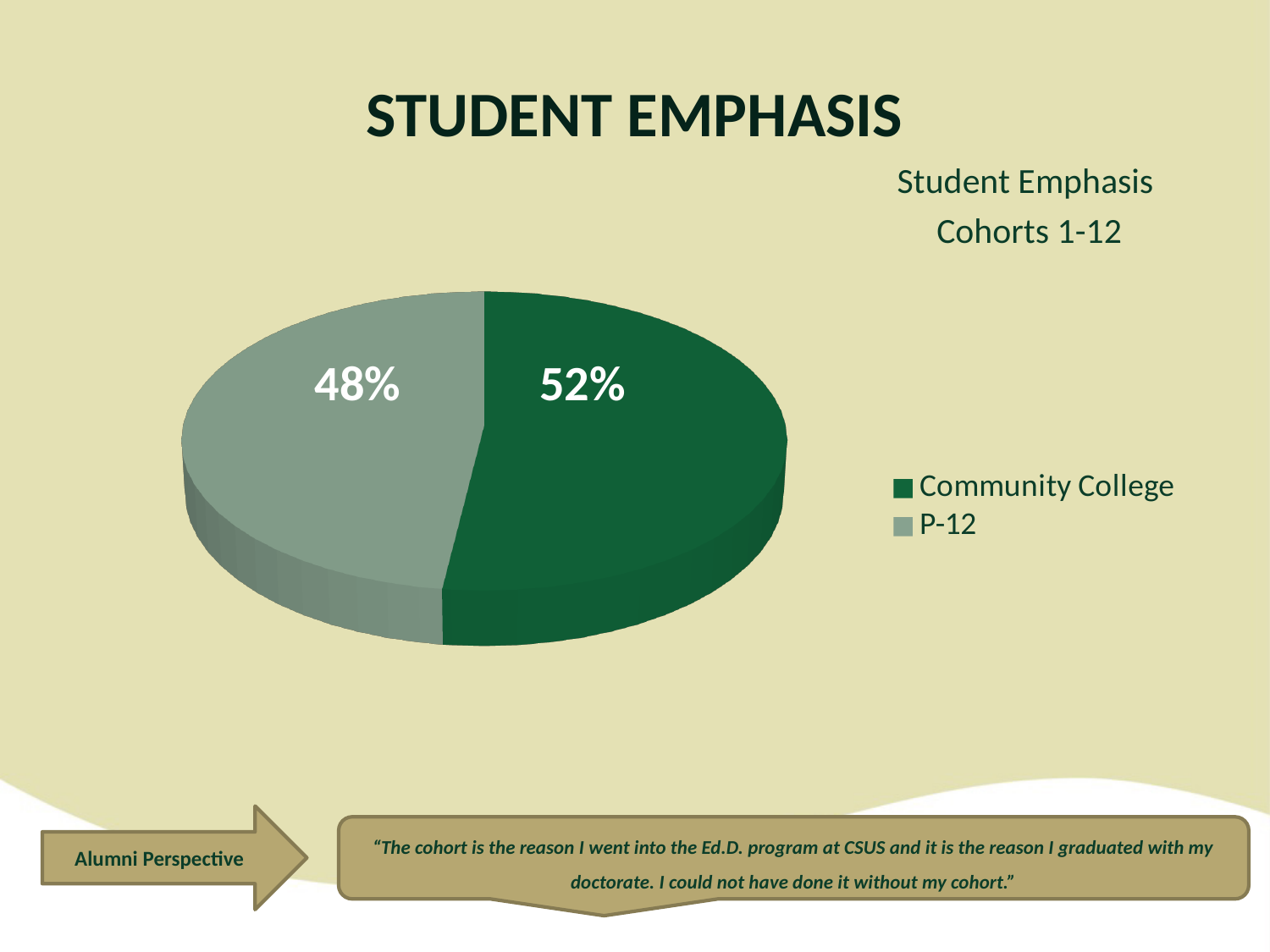
Which category has the largest share of the pie? Community College What kind of chart is shown on the slide? Pie chart How many entries does the legend list? 2 Which category has the smallest share of the pie? P-12 Which legend entry is shown in dark green? Community College How many slices does the pie chart have? 2 Which is larger, the share for Community College or the share for P-12? Community College What is the title of the chart? Student Emphasis Cohorts 1-12 What is the difference in percentage points between the Community College and P-12 shares? 4 percentage points What share of the pie does P-12 represent? 48% What share of the pie does Community College represent? 52%